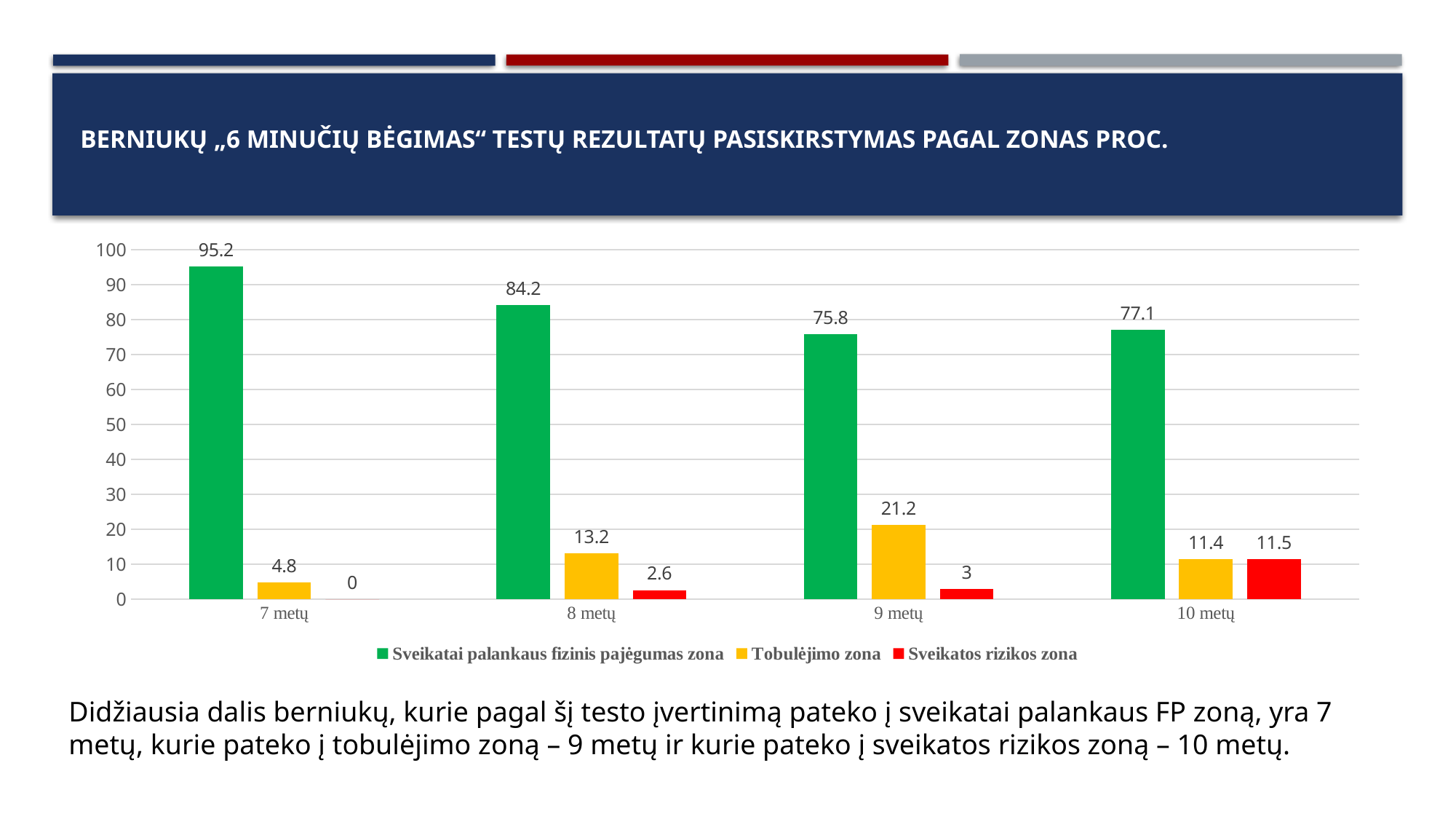
What is the value for "Sveikatai palankaus fizinis pajėgumas zona" for 7 metų? 95.2 Which is larger: the "Tobulėjimo zona" value for 8 metų or for 10 metų? 8 metų What is the difference between the "Sveikatai palankaus fizinis pajėgumas zona" values for 7 metų and 8 metų? 11 Which age group has the lowest value for "Tobulėjimo zona"? 7 metų What is the value for "Sveikatos rizikos zona" for 10 metų? 11.5 How many age groups are shown on the x axis? 4 What is the value for "Sveikatos rizikos zona" for 7 metų? 0 Which colour represents "Sveikatos rizikos zona" in the chart? Red What is the value for "Tobulėjimo zona" for 9 metų? 21.2 What kind of chart is shown on the slide? Bar chart Which age group has the highest value for "Sveikatai palankaus fizinis pajėgumas zona"? 7 metų How many series does the legend list? 3